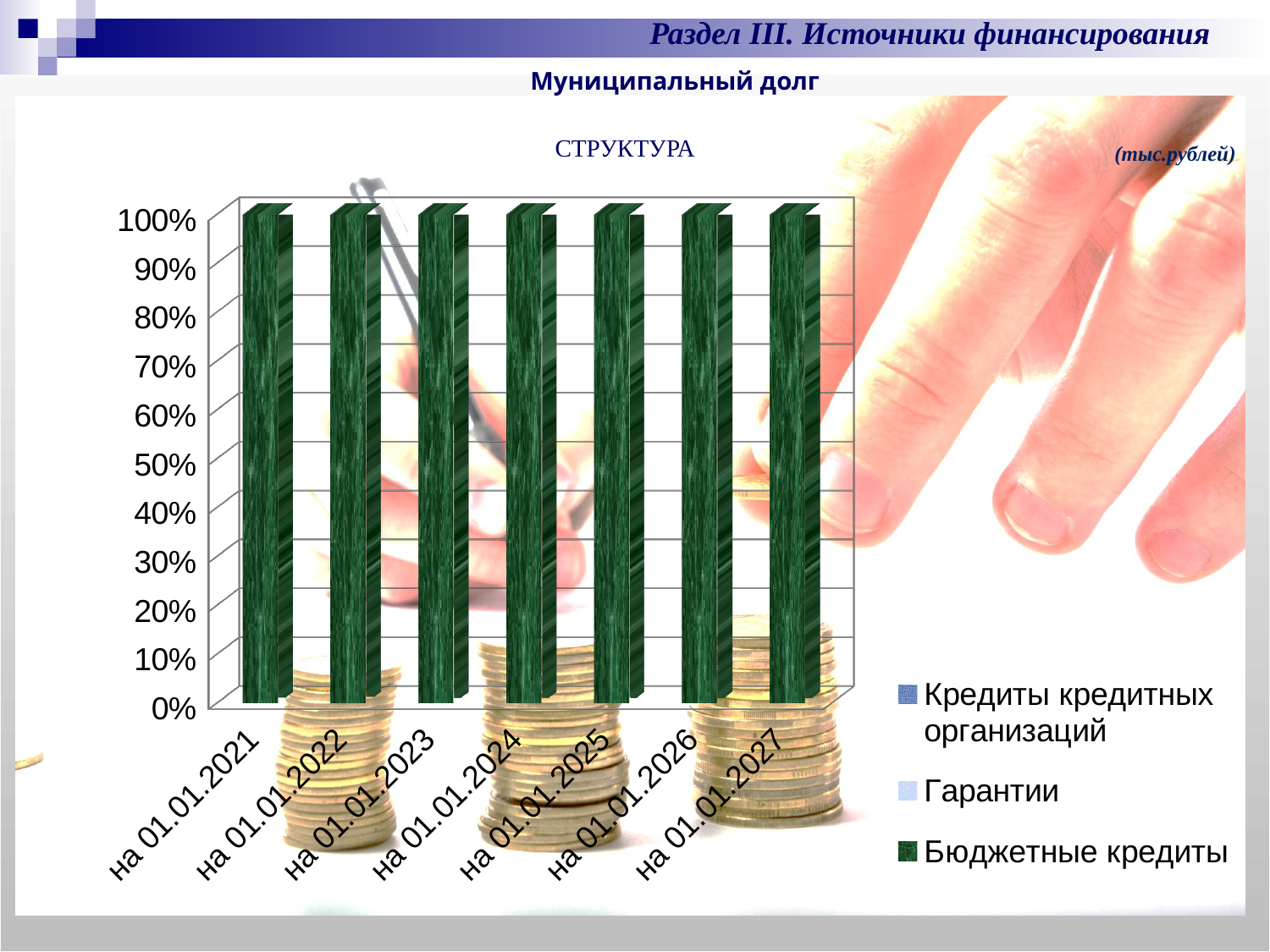
Does the share of Бюджетные кредиты rise, fall, or stay the same from 01.01.2021 to 01.01.2027? stay the same How many dates (categories) are shown on the x axis of the chart? 7 How many series does the chart legend list? 3 Is the share of Бюджетные кредиты on 01.01.2023 greater or less than 50%? greater Which series is shown in dark green in the chart legend? Бюджетные кредиты What share of the municipal debt do Бюджетные кредиты make up on 01.01.2024? 100% What is the highest value shown on the chart's vertical axis? 100% What is the title of the chart? СТРУКТУРА What is the first date shown on the x axis of the chart? на 01.01.2021 What share of the municipal debt do Бюджетные кредиты make up on 01.01.2021? 100% What share of the municipal debt do Бюджетные кредиты make up on 01.01.2027? 100% What kind of chart is shown on the slide? bar chart